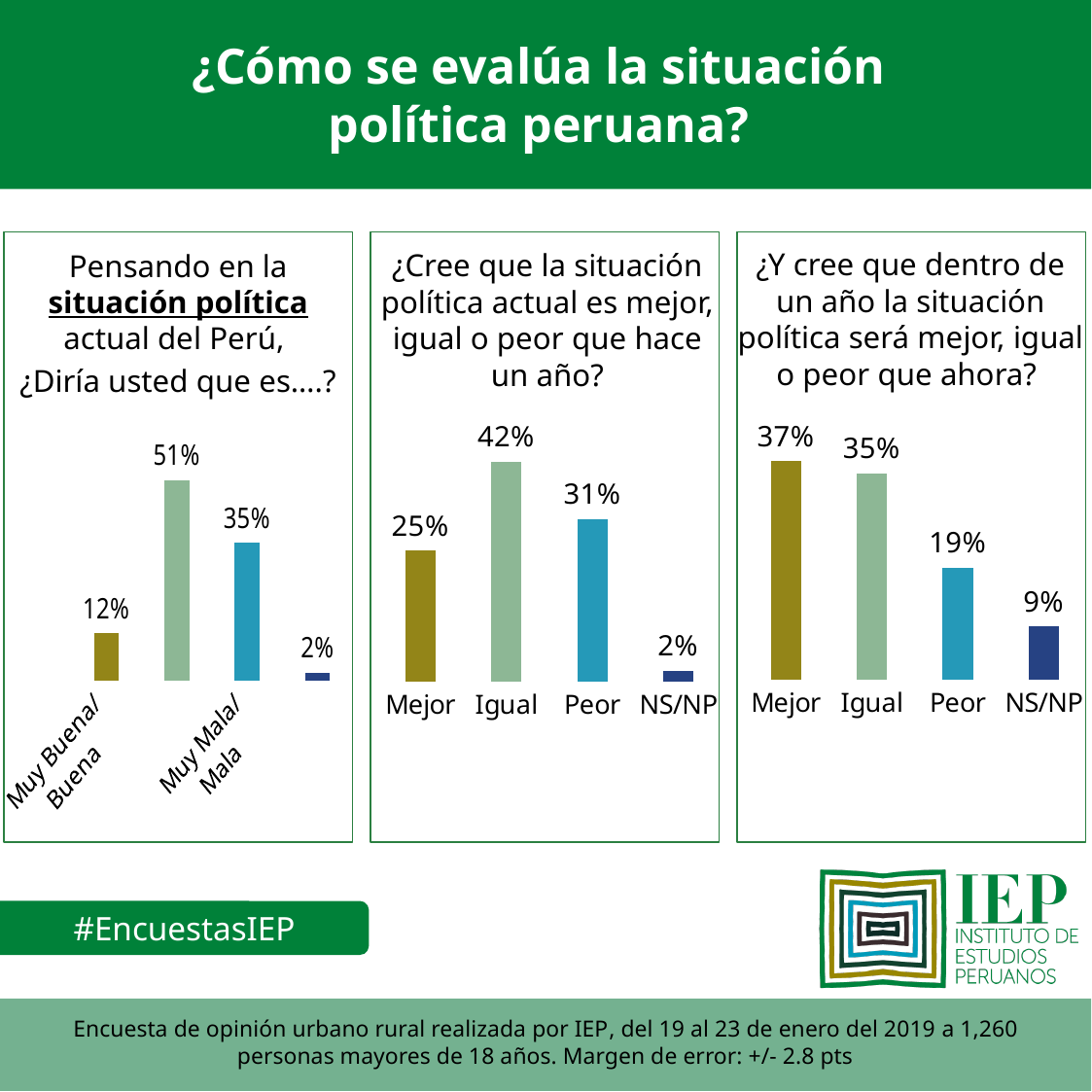
In the middle chart, what is the value for NS/NP? 2% In the right chart, which is larger, the value for Peor or the value for NS/NP? Peor In the middle chart, which category has the highest value? Igual What kind of chart is the right chart? Bar chart In the left chart (Pensando en la situación política actual del Perú), what is the value for Muy Buena/Buena? 12% In the middle chart (¿Cree que la situación política actual es mejor, igual o peor que hace un año?), what is the value for Igual? 42% In the right chart, what is the difference between the values for Mejor and Peor? 18% In the right chart (¿Y cree que dentro de un año la situación política será mejor, igual o peor que ahora?), what is the value for Mejor? 37% In the right chart, which category has the lowest value? NS/NP In the middle chart, what is the difference between the values for Igual and Peor? 11% In the left chart (Pensando en la situación política actual del Perú), what is the value for Muy Mala/Mala? 35% In the middle chart, how many categories are shown? 4